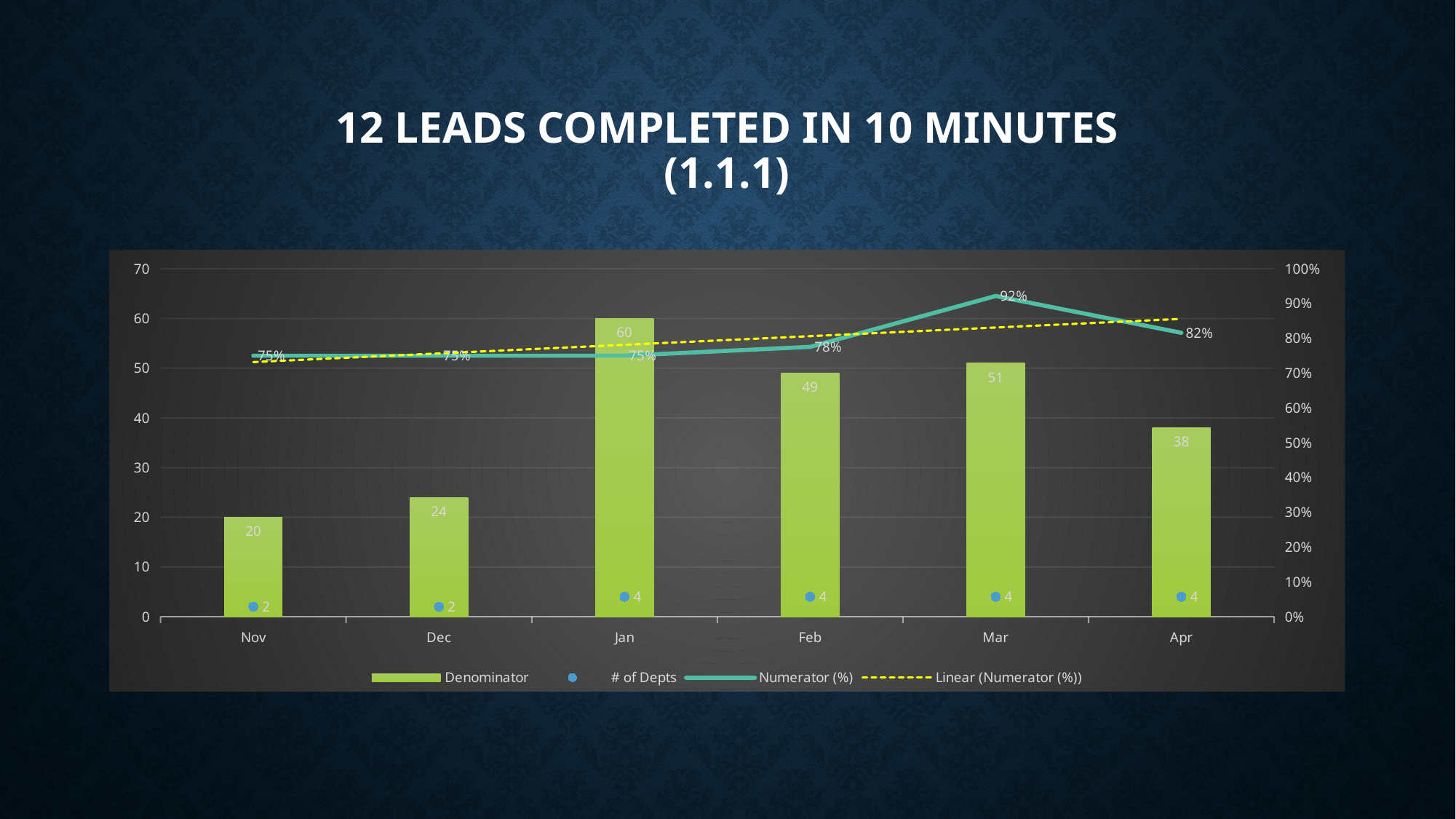
Which month has the lowest Denominator value? Nov Which is larger, the Denominator value for Feb or for Mar? Mar How many series does the legend list? 4 What is the difference between the Denominator values for Jan and Apr? 22 What is the Numerator (%) value for Apr? 82% What is the # of Depts value for Nov? 2 What is the Numerator (%) value for Mar? 92% How many months are shown on the x axis? 6 Which month has the highest Denominator value? Jan What is the Denominator value for Jan? 60 Which month has the highest Numerator (%) value? Mar What is the title of the chart slide? 12 Leads Completed in 10 Minutes (1.1.1)